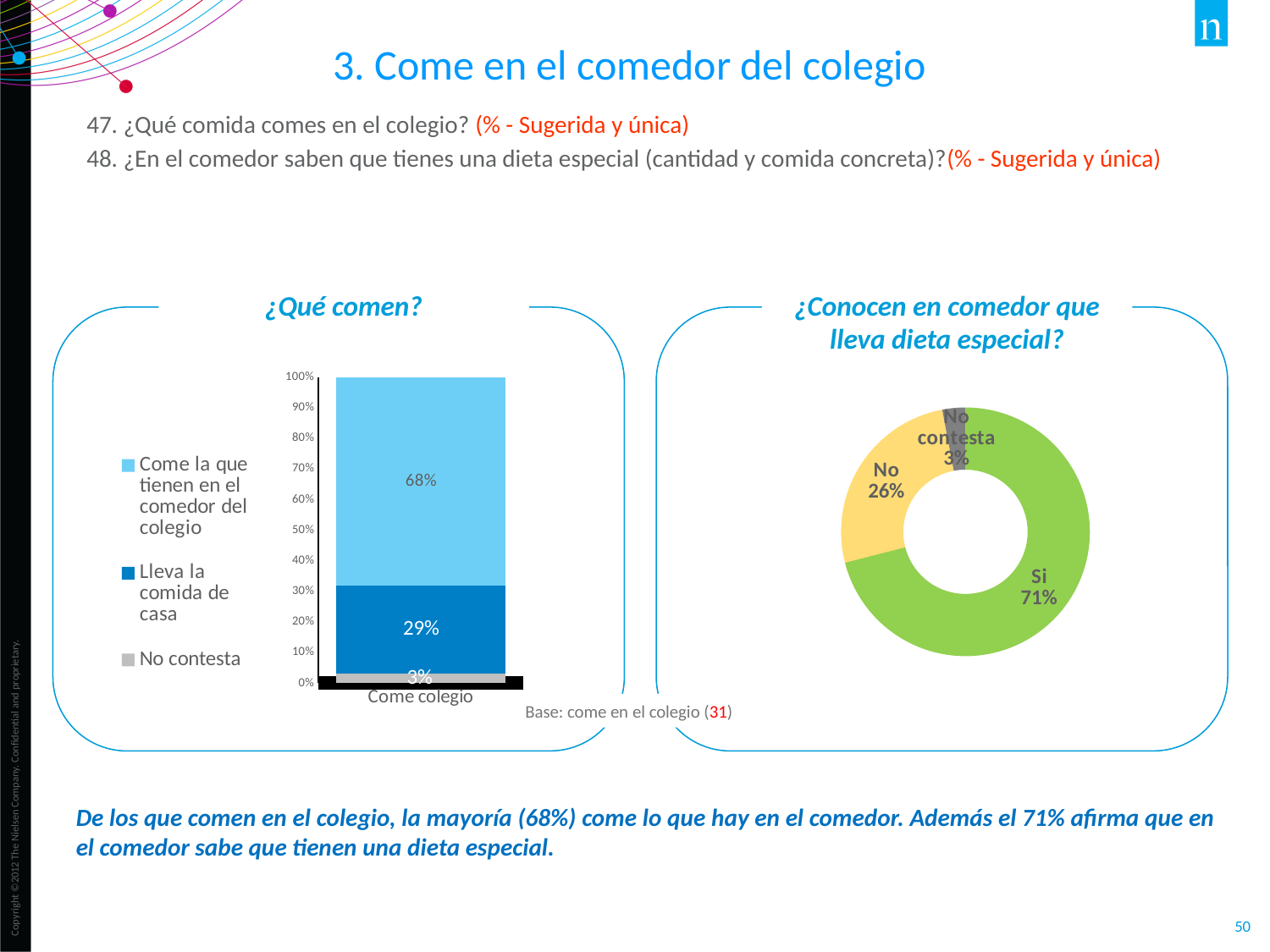
In the '¿Qué comen?' chart, what is the label of the category on the x axis? Come colegio In the '¿Qué comen?' chart, what percentage is shown for 'Come la que tienen en el comedor del colegio'? 68% In the '¿Qué comen?' chart, how many series does the legend list? 3 In the '¿Conocen en comedor que lleva dieta especial?' chart, what percentage is shown for 'Si'? 71% In the '¿Qué comen?' chart, what percentage is shown for 'Lleva la comida de casa'? 29% What kind of chart is the '¿Conocen en comedor que lleva dieta especial?' chart? Doughnut chart In the '¿Qué comen?' chart, what is the difference between the 'Come la que tienen en el comedor del colegio' value and the 'Lleva la comida de casa' value? 39% In the '¿Qué comen?' chart, which series has the largest value? Come la que tienen en el comedor del colegio What kind of chart is the '¿Qué comen?' chart? Stacked bar chart In the '¿Conocen en comedor que lleva dieta especial?' chart, what percentage is shown for 'No'? 26% In the '¿Conocen en comedor que lleva dieta especial?' chart, which slice is the smallest? No contesta In the '¿Conocen en comedor que lleva dieta especial?' chart, what is the difference between the 'Si' and 'No' values? 45%